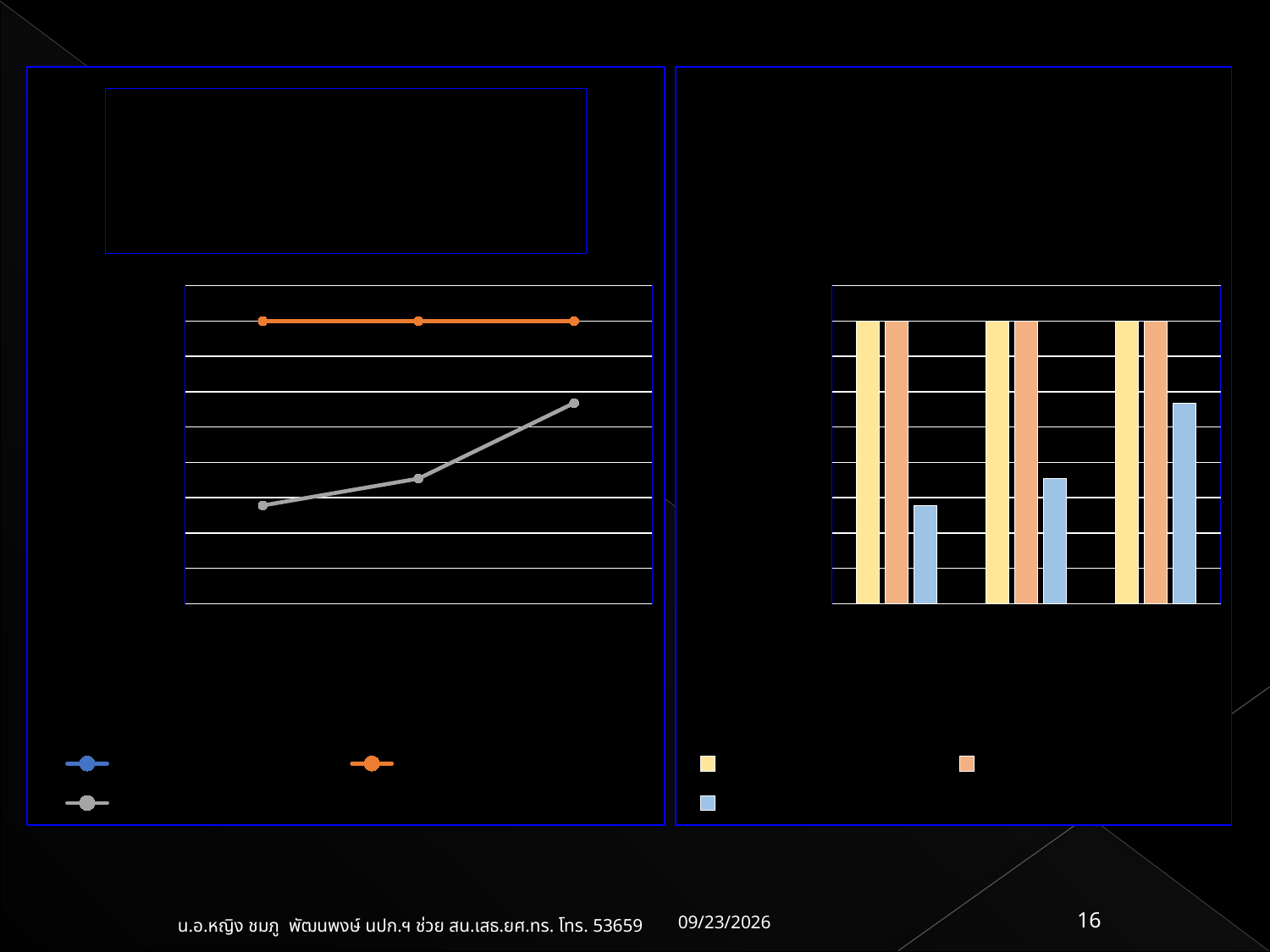
In the left chart, does the orange line rise, fall, or stay flat from left to right? stay flat What kind of chart is the chart on the left side of the slide? line chart In the right chart, how many series does the legend list? 3 In the left chart, which line is plotted higher, the orange line or the grey line? the orange line In the right chart, do the light blue bars get taller or shorter from the left group to the right group? taller In the left chart, do the values of the grey line rise or fall from left to right? rise In the right chart, which series has the shortest bar in every group? the light blue series What kind of chart is the chart on the right side of the slide? bar chart In the right chart, how many groups of bars are plotted along the x axis? 3 In the left chart, how many series does the legend list? 3 In the right chart, which is taller in the first group: the yellow bar or the light blue bar? the yellow bar In the left chart, how many data points does the grey line have? 3